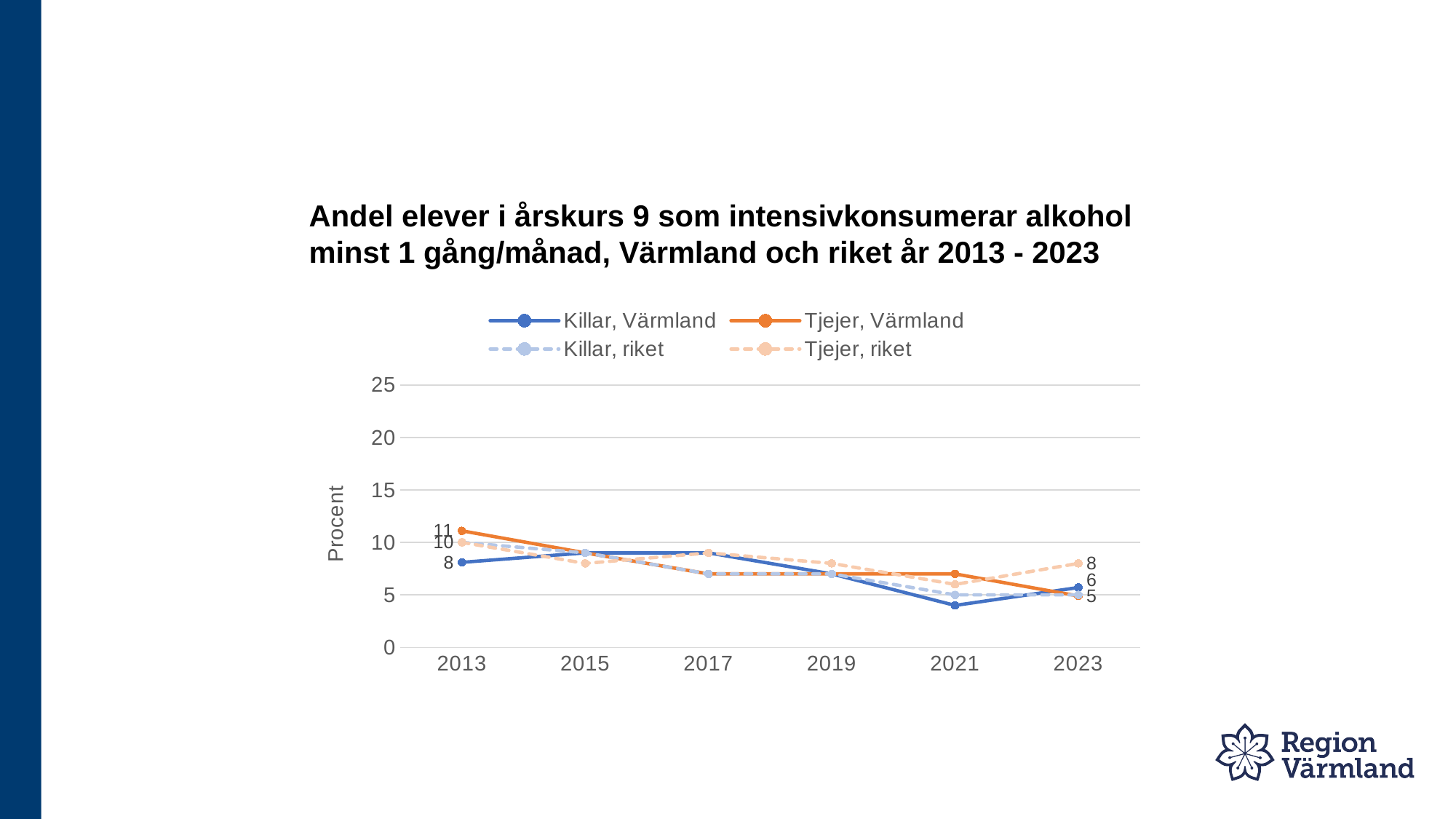
Is the value for Killar, Värmland in 2021 greater or less than 5? less What kind of chart is shown on the slide? line chart What is the difference between Tjejer, Värmland and Killar, Värmland in 2013? 3 What is the value for Killar, Värmland in 2023? 6 Does the value for Tjejer, Värmland rise or fall from 2013 to 2023? fall Which is larger for Killar, Värmland: the value in 2013 or the value in 2023? 2013 What is the value for Killar, Värmland in 2013? 8 How many series does the legend list? 4 What is the value for Tjejer, riket in 2023? 8 What is the value for Tjejer, Värmland in 2013? 11 How many years are shown on the x axis? 6 Which series has the highest value in 2013? Tjejer, Värmland